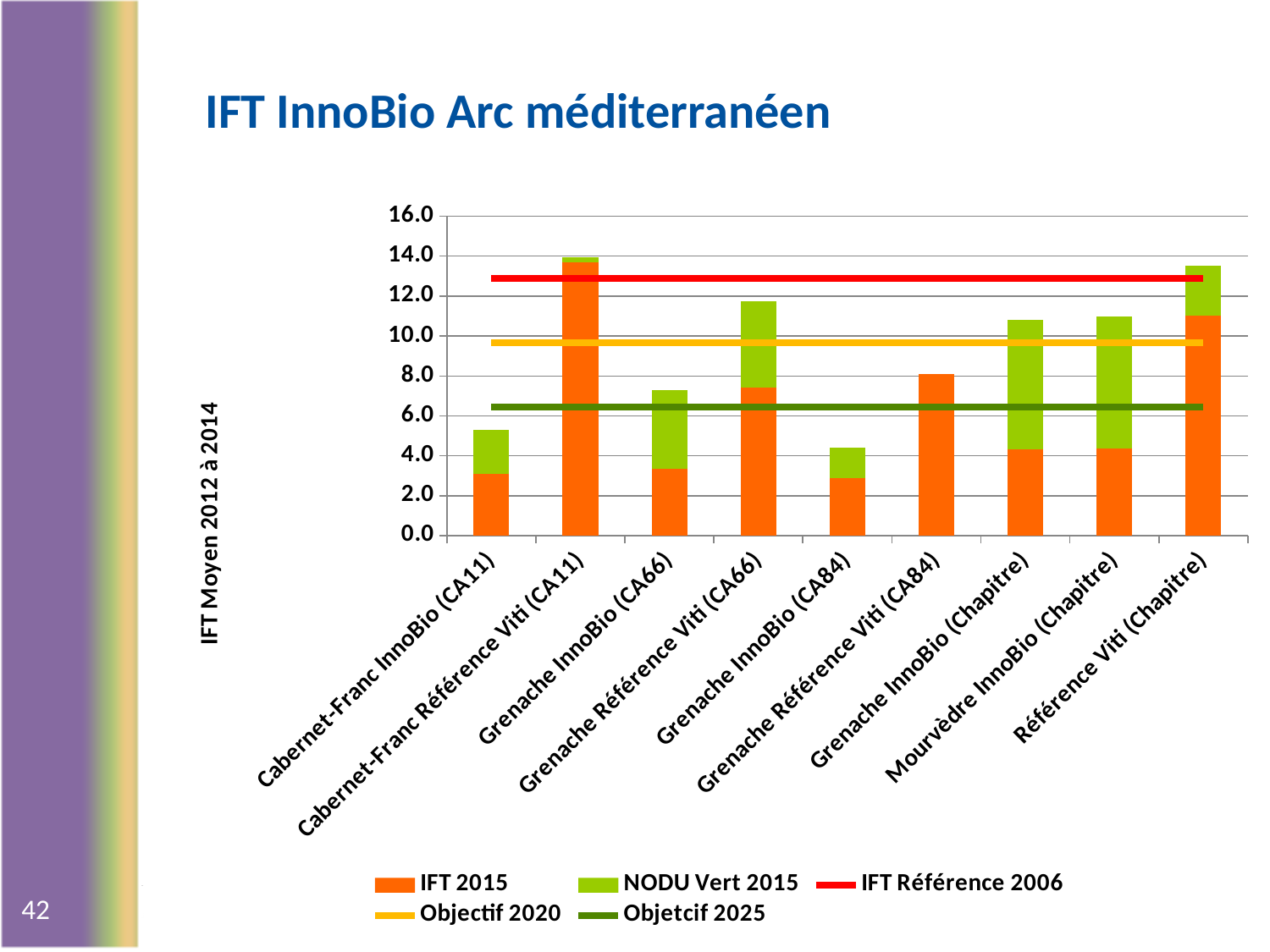
Is the total bar for Grenache InnoBio (CA66) greater or less than 8.0? less Which has the larger total bar: Grenache Référence Viti (CA66) or Grenache InnoBio (CA66)? Grenache Référence Viti (CA66) Which category has the lowest total bar in the chart? Grenache InnoBio (CA84) What is the title of the chart's vertical axis? IFT Moyen 2012 à 2014 Is the total bar for Cabernet-Franc Référence Viti (CA11) greater or less than 12.0? greater Is the total bar for Grenache InnoBio (CA84) greater or less than 6.0? less Which has the larger total bar: Référence Viti (Chapitre) or Mourvèdre InnoBio (Chapitre)? Référence Viti (Chapitre) How many categories are shown along the x axis of the chart? 9 What kind of chart is shown on the slide? Combination chart: stacked bar chart with horizontal line series Which legend entry is drawn as a red horizontal line? IFT Référence 2006 How many series does the chart legend list? 5